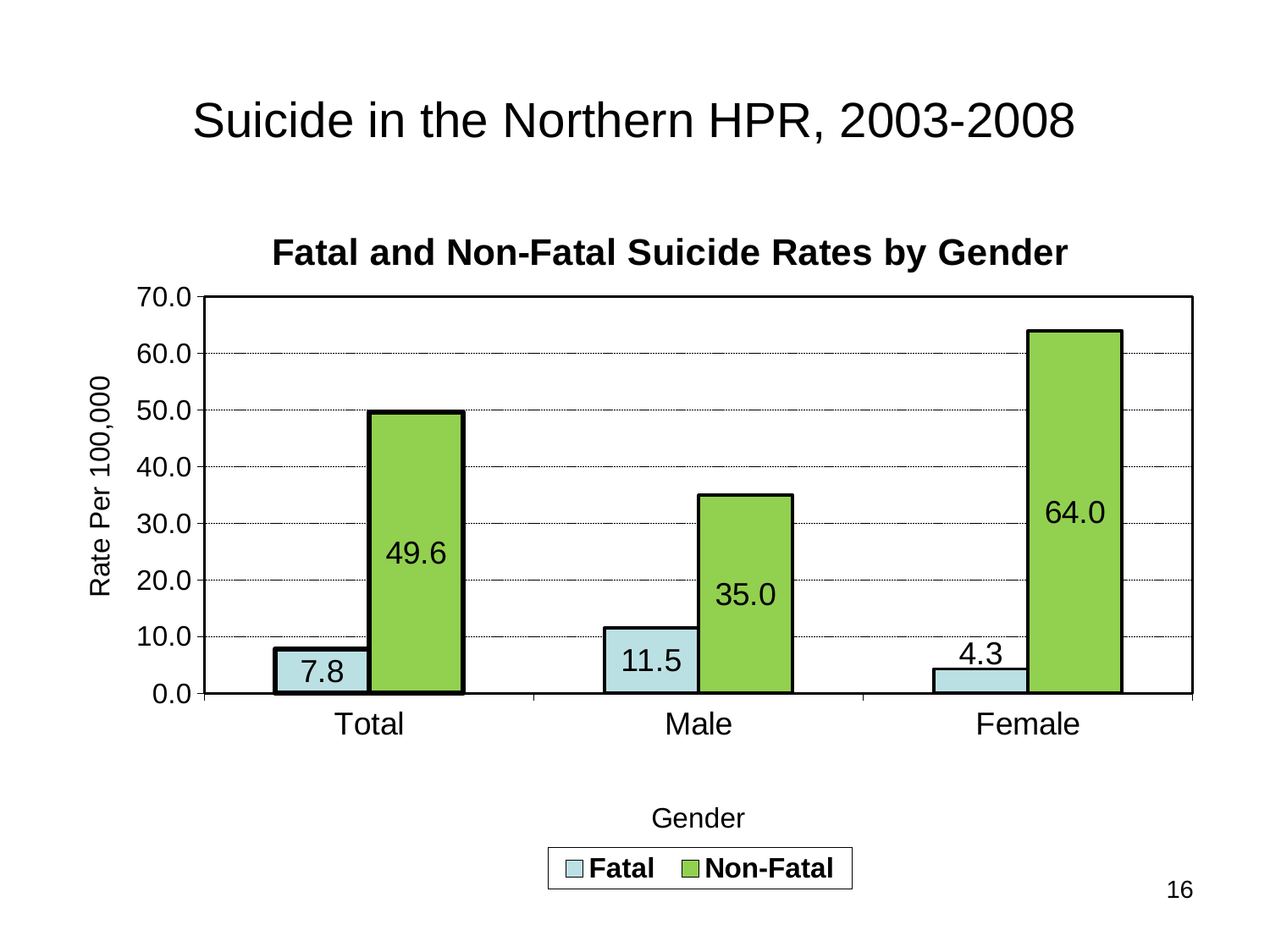
What is the difference between the Non-Fatal rates for Female and Male? 29.0 What kind of chart is shown on the slide? Bar chart What is the Non-Fatal suicide rate for Female? 64.0 How many series does the legend list? 2 What is the Fatal suicide rate for Female? 4.3 What is the Non-Fatal suicide rate for Total? 49.6 Which gender category has the highest Non-Fatal rate? Female How many gender categories are shown on the x axis? 3 Which is larger, the Fatal rate for Male or the Fatal rate for Total? Male What is the Fatal suicide rate for Male? 11.5 Which gender category has the lowest Fatal rate? Female Is the Non-Fatal rate for Male greater or less than 40.0? less